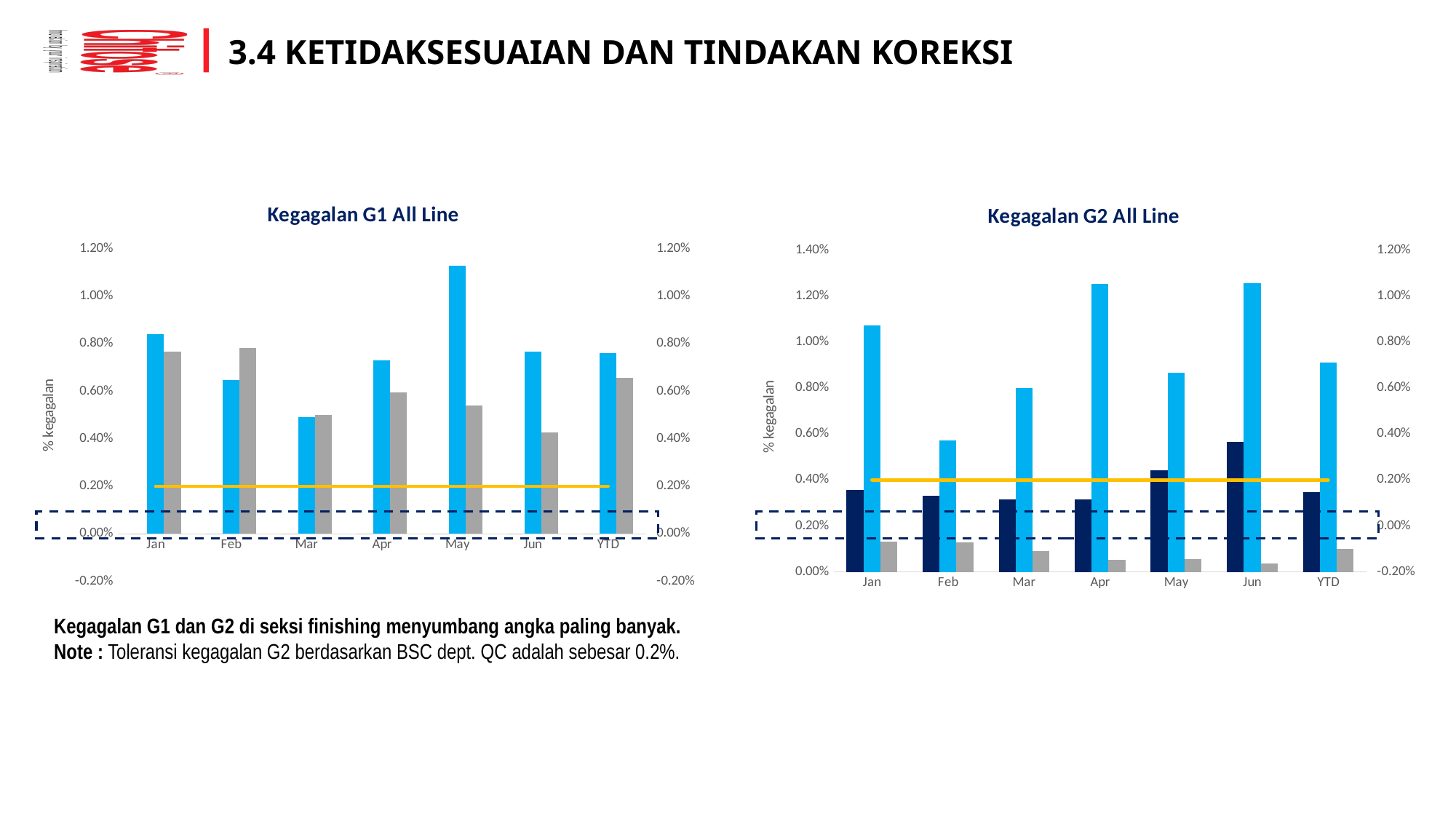
In the "Kegagalan G1 All Line" chart, which month has the tallest light blue bar? May How many categories are shown on the x axis of the "Kegagalan G2 All Line" chart? 7 In the "Kegagalan G2 All Line" chart, which category has the tallest dark navy bar? Jun In the "Kegagalan G2 All Line" chart, which month has the shortest light blue bar? Feb In the "Kegagalan G1 All Line" chart, is the light blue bar for Mar greater or less than 0.60%? less In the "Kegagalan G1 All Line" chart, for Feb, which is taller: the light blue bar or the gray bar? the gray bar In the "Kegagalan G1 All Line" chart, which month has the shortest light blue bar? Mar What is the label on the vertical axis of the "Kegagalan G2 All Line" chart? % kegagalan In the "Kegagalan G1 All Line" chart, is the light blue bar for May greater or less than 1.00%? greater In the "Kegagalan G2 All Line" chart, is the light blue bar for Jan greater or less than 0.80%? greater In the "Kegagalan G1 All Line" chart, which category has the shortest gray bar? Jun What kind of chart is "Kegagalan G1 All Line"? combination bar and line chart